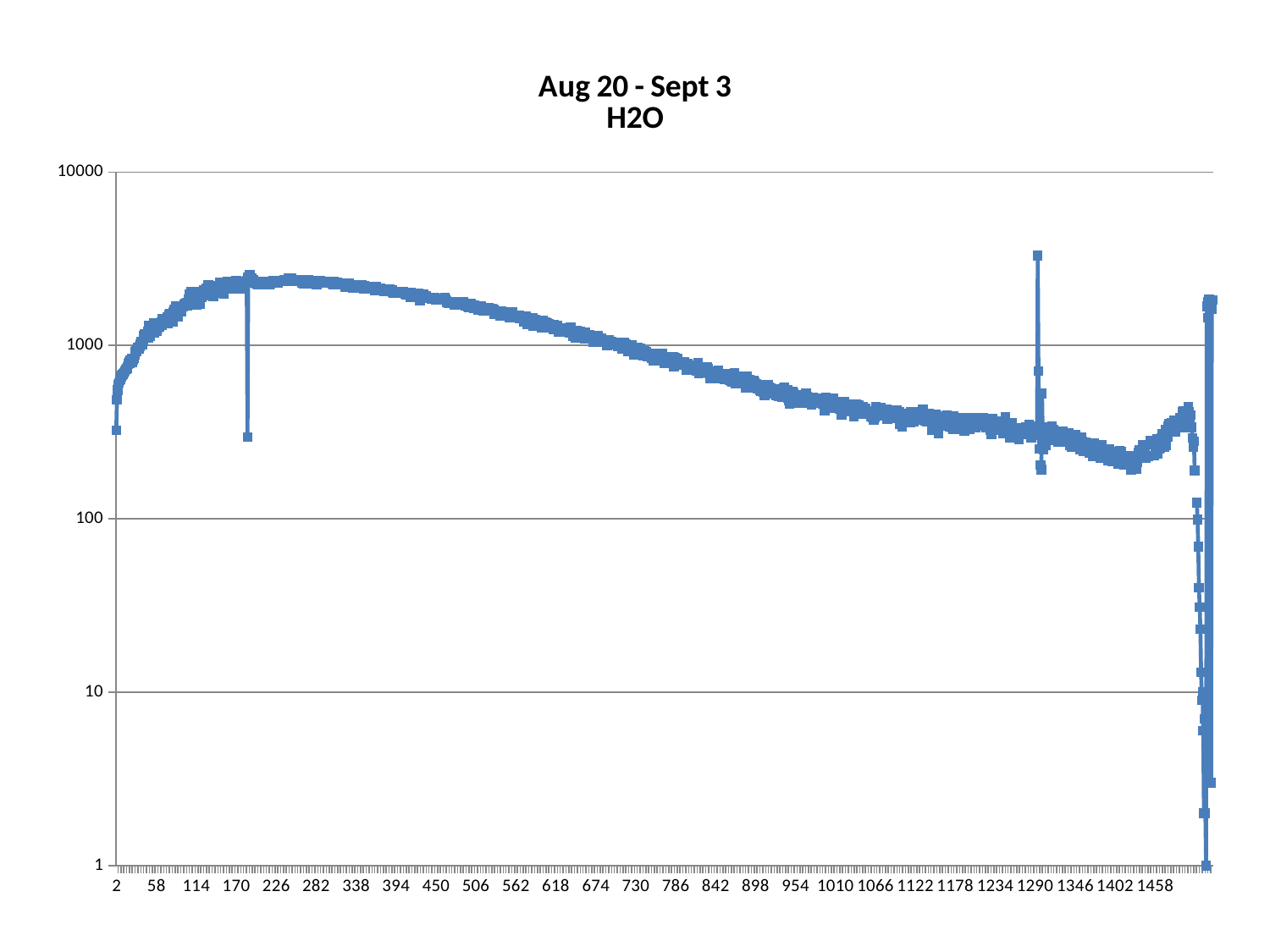
What is the title of the chart? Aug 20 - Sept 3 H2O Which is larger, the value at x = 282 or the value at x = 1402? 282 What is the highest value labelled on the y axis? 10000 Is the value at x = 1402 greater or less than 1000? less Is the value at x = 2 greater or less than 1000? less Is the value at x = 282 greater or less than 1000? greater Near which x-axis label does the tallest upward spike in the line occur? 1290 Do the values generally rise or fall along the x axis between 282 and 1402? fall What kind of chart is shown on the slide? line chart Do the values rise or fall along the x axis between 2 and 226? rise